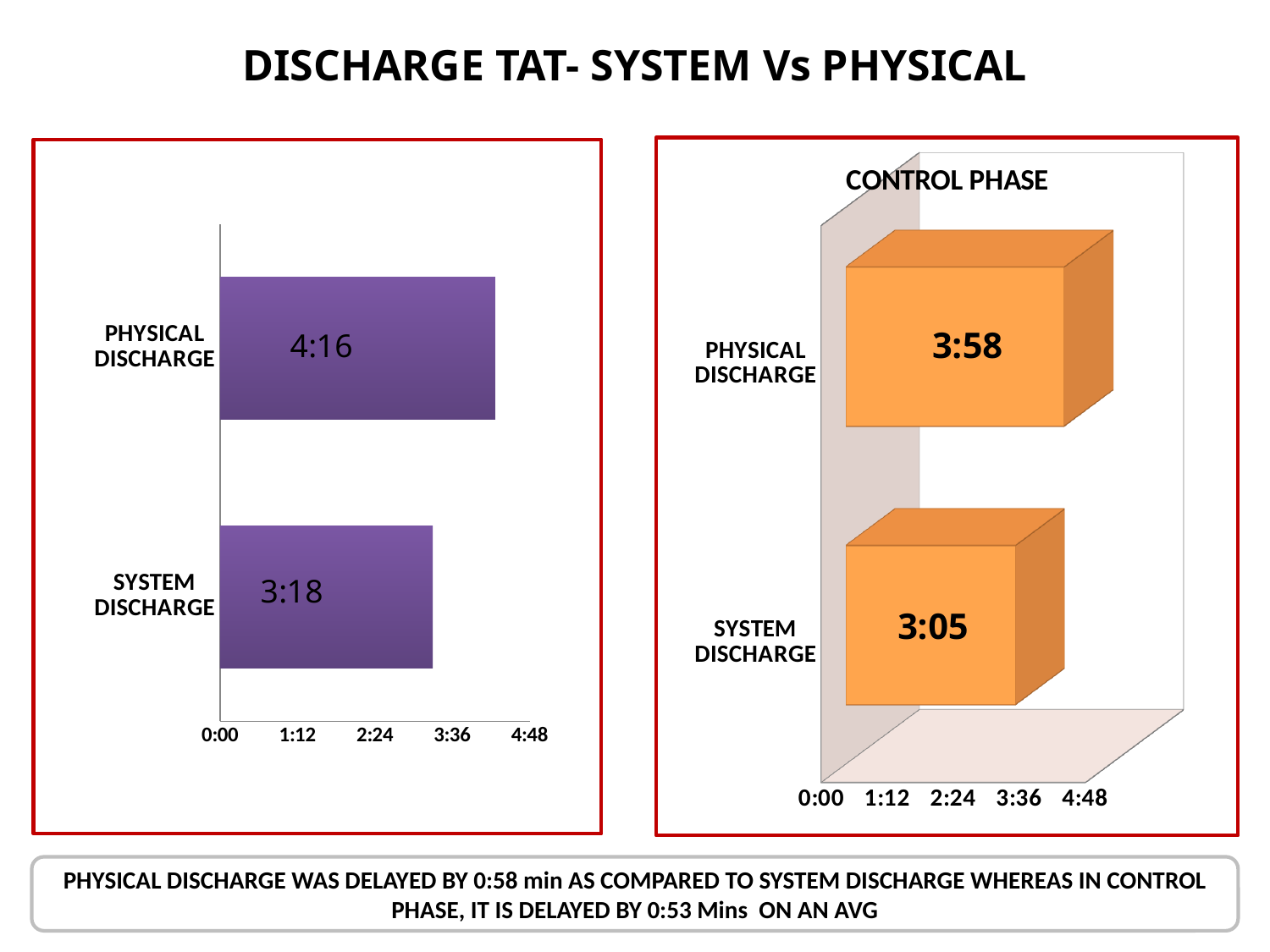
On the CONTROL PHASE chart, which category has the lower value? SYSTEM DISCHARGE Is the PHYSICAL DISCHARGE value on the left chart larger or smaller than the PHYSICAL DISCHARGE value on the CONTROL PHASE chart? larger On the CONTROL PHASE chart, what is the difference between PHYSICAL DISCHARGE and SYSTEM DISCHARGE? 0:53 What type of chart is the CONTROL PHASE chart? Bar chart On the CONTROL PHASE chart, what is the value for SYSTEM DISCHARGE? 3:05 On the CONTROL PHASE chart, what is the value for PHYSICAL DISCHARGE? 3:58 On the left chart, which category has the higher value? PHYSICAL DISCHARGE On the left chart, what is the value for PHYSICAL DISCHARGE? 4:16 On the left chart, what is the difference between PHYSICAL DISCHARGE and SYSTEM DISCHARGE? 0:58 On the left chart, what is the value for SYSTEM DISCHARGE? 3:18 On the left chart, is the value for SYSTEM DISCHARGE greater or less than 3:36? less How many categories does the CONTROL PHASE chart show? 2